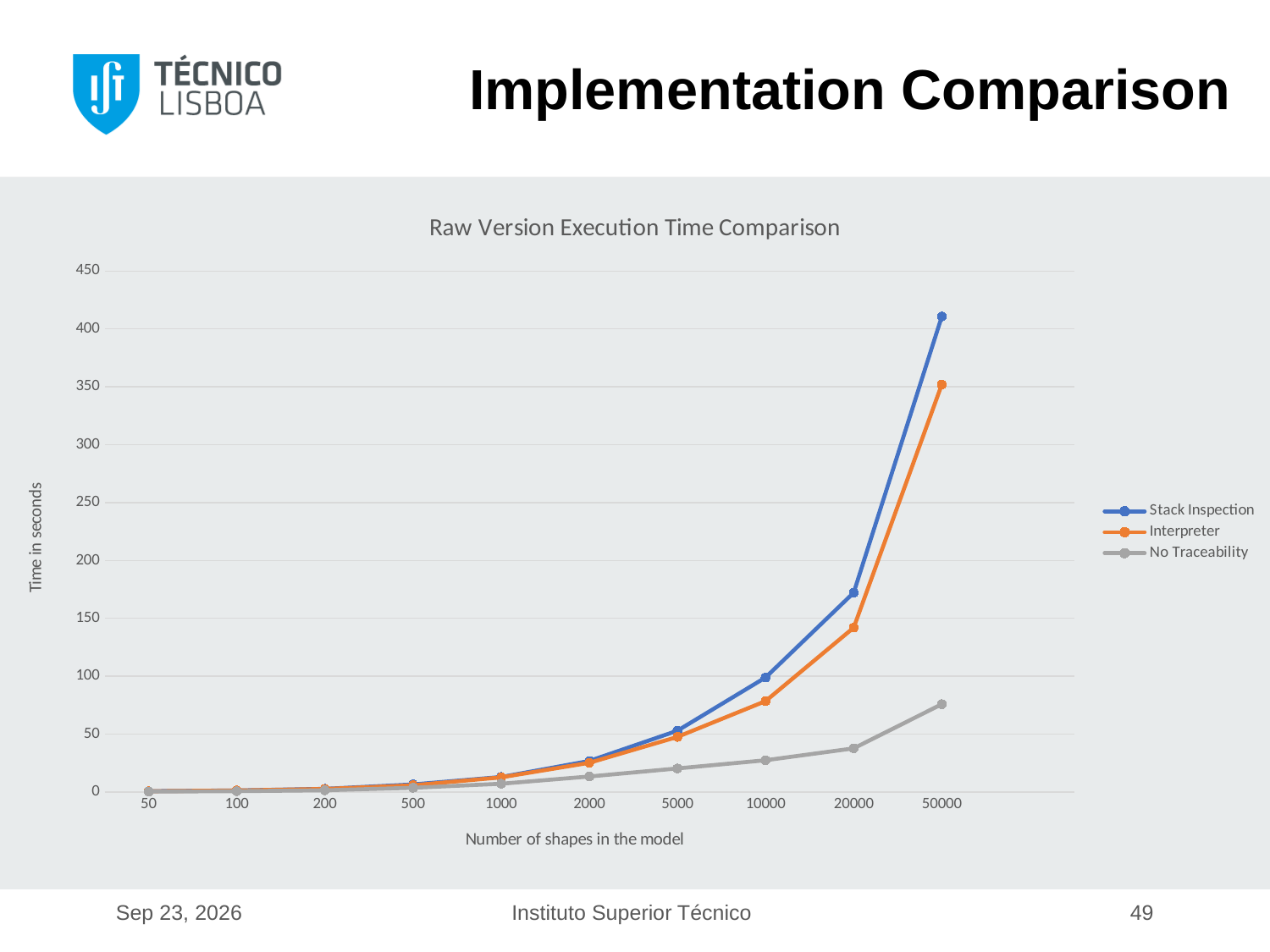
Is the value for Stack Inspection at 20000 shapes greater or less than 150? greater Is the value for No Traceability at 50000 shapes greater or less than 100? less Is the value for Interpreter at 20000 shapes greater or less than 150? less Which series has the lowest value at 50000 shapes? No Traceability What kind of chart is shown on the slide? line chart Do the execution times rise or fall as the number of shapes increases? rise How many series does the legend list? 3 Which series has the highest value at 50000 shapes? Stack Inspection How many x-axis categories (numbers of shapes) are plotted? 10 At 20000 shapes, which is larger: Stack Inspection or No Traceability? Stack Inspection